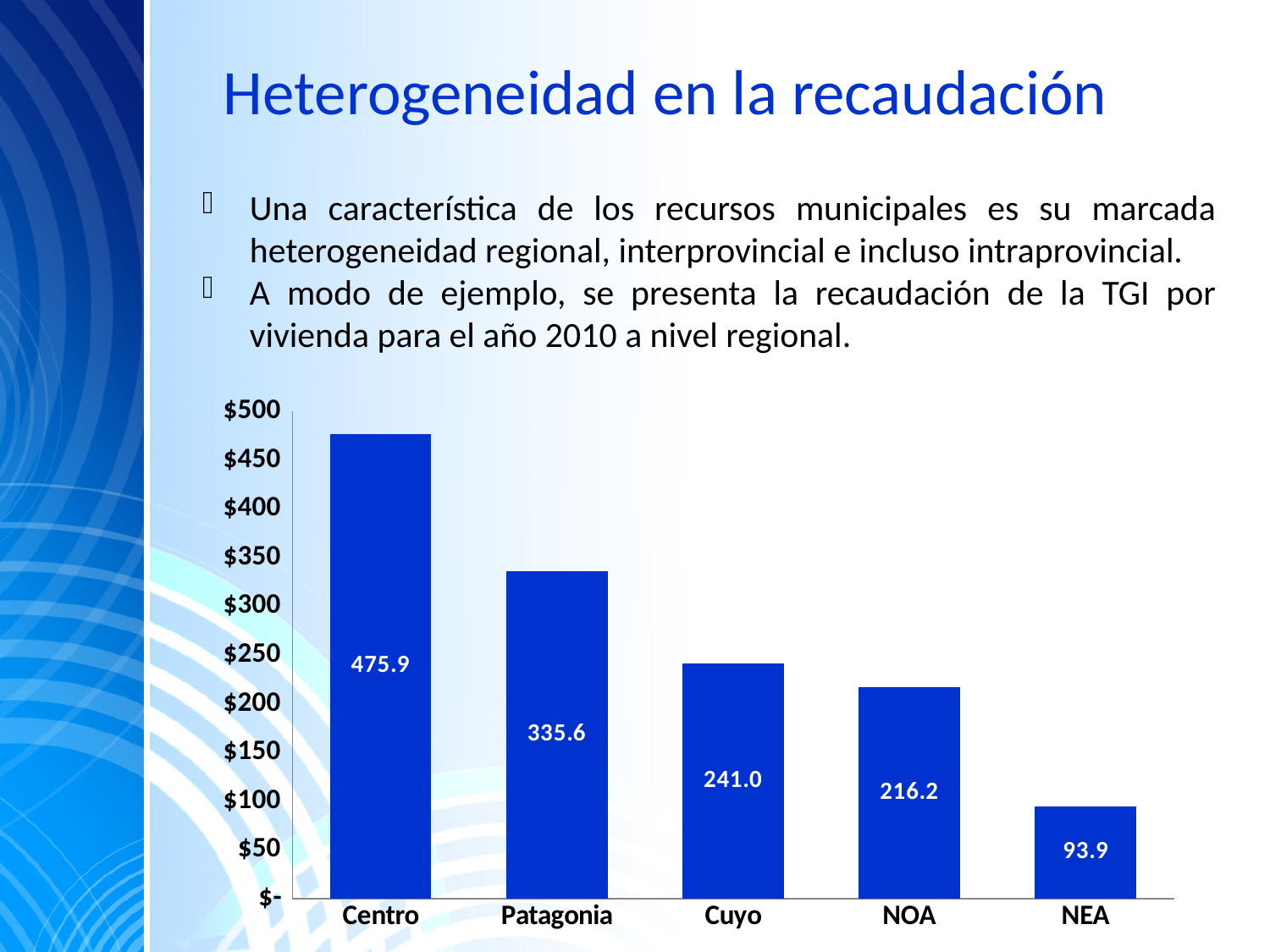
Is the value for NEA greater or less than $100? less What is the difference between the values for Centro and Patagonia? 140.3 Which is larger, the value for Cuyo or the value for NOA? Cuyo Do the values rise or fall from Centro to NEA along the x axis? fall What is the value for Patagonia? 335.6 What is the value for Centro? 475.9 What is the value for NEA? 93.9 Which region has the lowest value? NEA How many regions are shown on the chart? 5 What kind of chart is shown on the slide? bar chart Which region has the highest value? Centro What is the difference between the values for Cuyo and NOA? 24.8